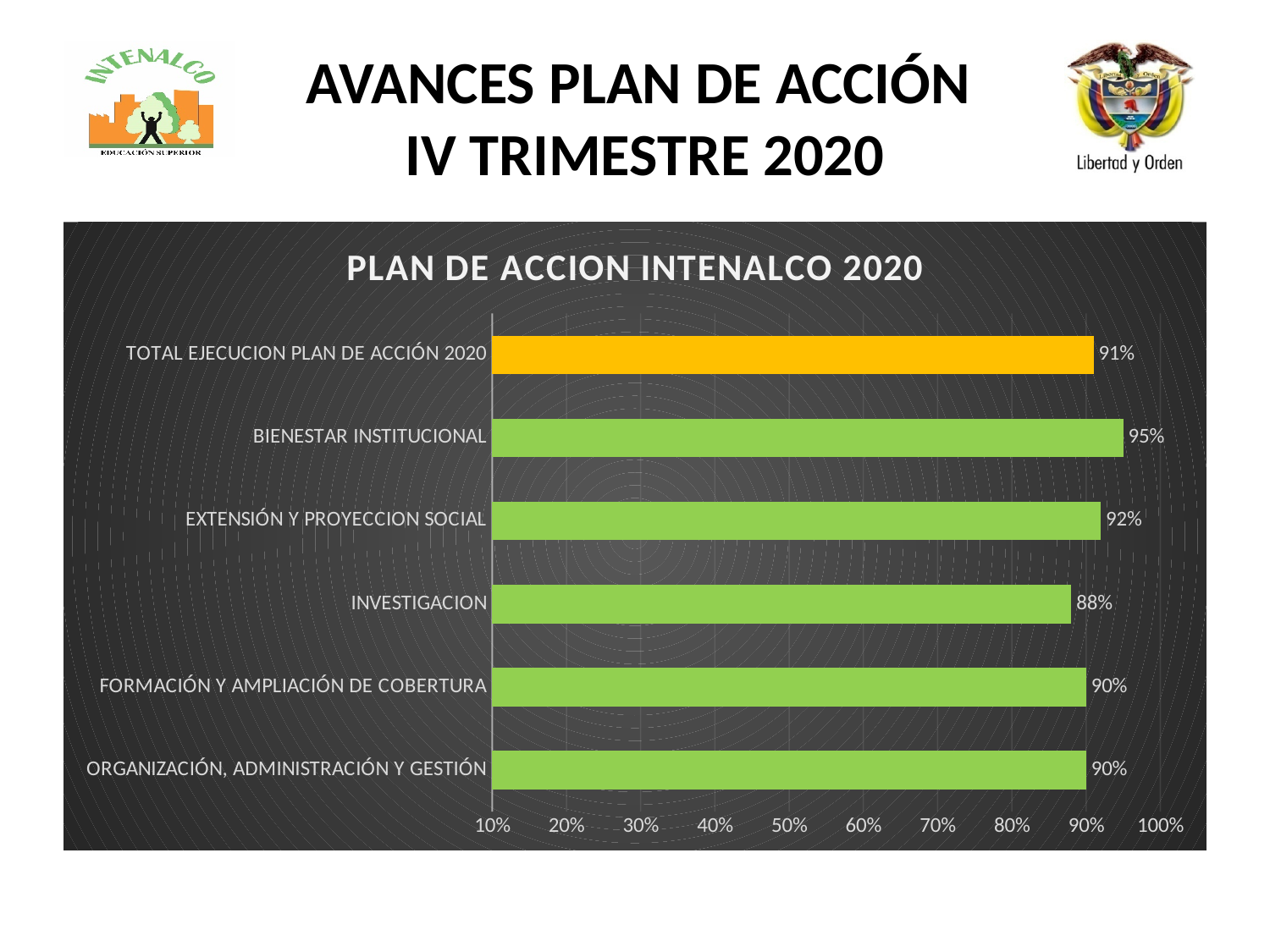
What is the difference between BIENESTAR INSTITUCIONAL and INVESTIGACION? 7% Which category has the highest value? BIENESTAR INSTITUCIONAL What is the value for INVESTIGACION? 88% What is the value for EXTENSIÓN Y PROYECCION SOCIAL? 92% What is the value for TOTAL EJECUCION PLAN DE ACCIÓN 2020? 91% What kind of chart is this? Bar chart What is the title of the chart? PLAN DE ACCION INTENALCO 2020 How many categories are shown in the chart? 6 Which is larger, EXTENSIÓN Y PROYECCION SOCIAL or FORMACIÓN Y AMPLIACIÓN DE COBERTURA? EXTENSIÓN Y PROYECCION SOCIAL Which category has the lowest value? INVESTIGACION What is the value for BIENESTAR INSTITUCIONAL? 95% Which bar is coloured differently (orange) from the others? TOTAL EJECUCION PLAN DE ACCIÓN 2020